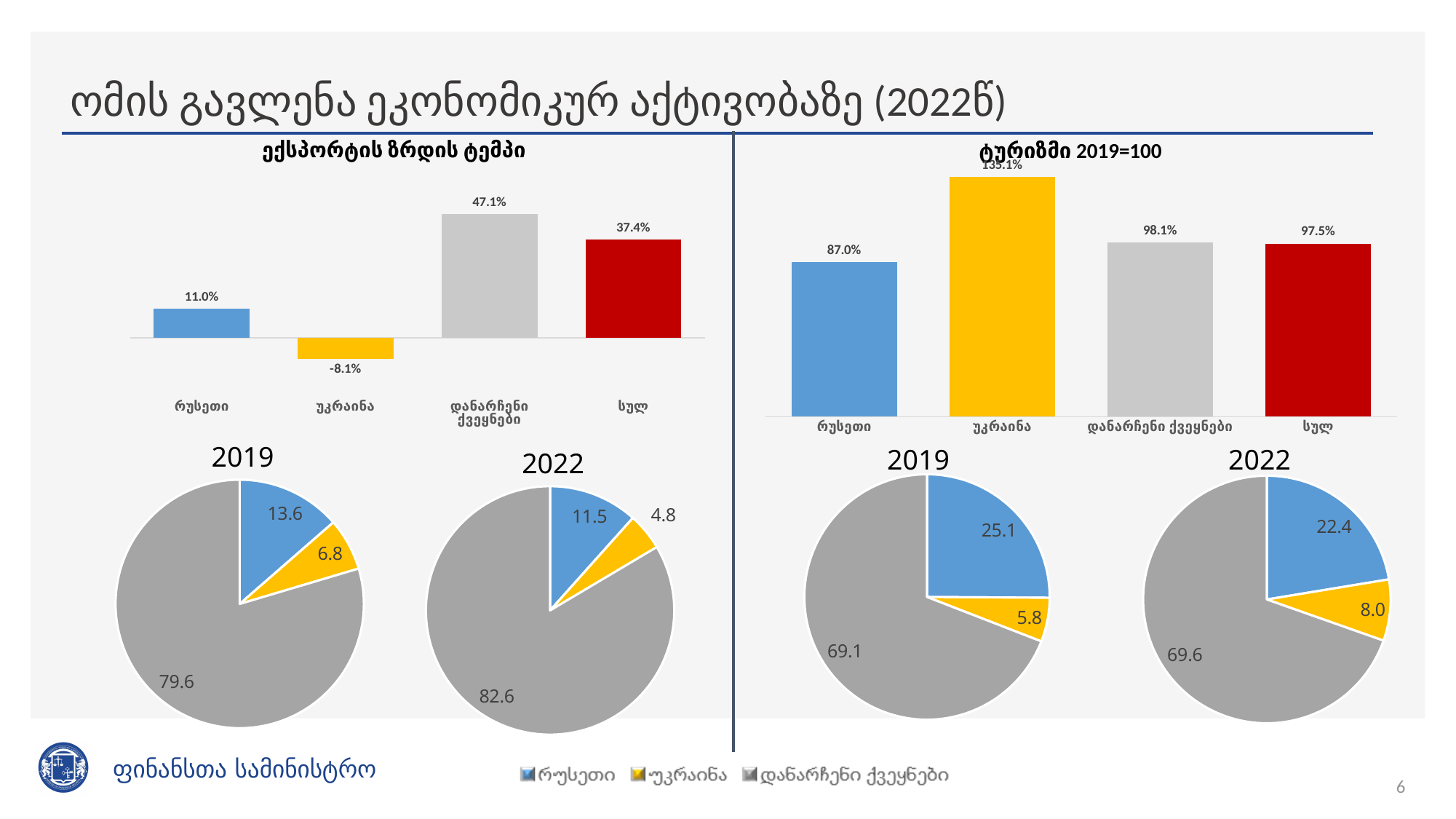
In the 2019 pie chart on the left side of the slide (below the export chart), what is the value of the რუსეთი slice? 13.6 In the bar chart titled "ტურიზმი 2019=100", which category has the highest value? უკრაინა In the bar chart titled "ტურიზმი 2019=100", what is the difference between the values for დანარჩენი ქვეყნები and სულ? 0.6% In the 2022 pie chart on the right side of the slide (below the tourism chart), what is the value of the უკრაინა slice? 8.0 In the bar chart titled "ტურიზმი 2019=100", what is the value for რუსეთი? 87.0% In the bar chart titled "ექსპორტის ზრდის ტემპი", how many categories are shown? 4 In the 2022 pie chart on the left side of the slide (below the export chart), which slice is the largest? დანარჩენი ქვეყნები In the bar chart titled "ექსპორტის ზრდის ტემპი", which category has the lowest value? უკრაინა In the bar chart titled "ექსპორტის ზრდის ტემპი", what is the value for უკრაინა? -8.1% What type of chart is the chart titled "ტურიზმი 2019=100"? Bar chart In the bar chart titled "ექსპორტის ზრდის ტემპი", which is larger: the value for რუსეთი or the value for სულ? სულ In the bar chart titled "ექსპორტის ზრდის ტემპი", which category has the highest value? დანარჩენი ქვეყნები